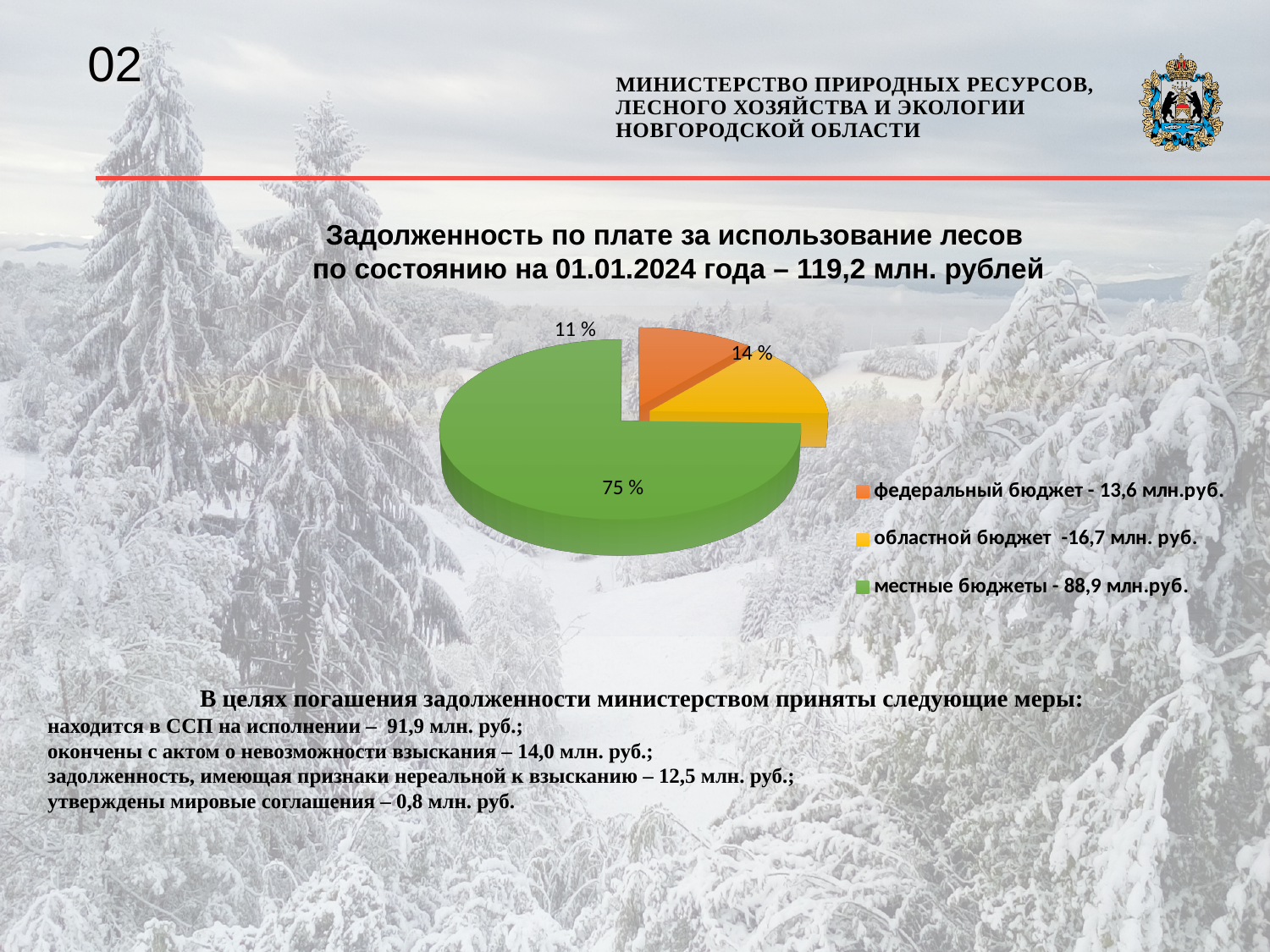
How many slices does the pie chart have? 3 According to the legend, what is the debt amount for местные бюджеты? 88,9 млн.руб. What share of the pie does the slice for областной бюджет represent? 14 % What is the difference in percentage points between the share for местные бюджеты and the share for федеральный бюджет? 64 How many entries does the legend of the pie chart list? 3 What share of the pie does the slice for местные бюджеты represent? 75 % According to the legend, what is the debt amount for федеральный бюджет? 13,6 млн.руб. Which category has the smallest slice of the pie? федеральный бюджет Which category has the largest slice of the pie? местные бюджеты What share of the pie does the slice for федеральный бюджет represent? 11 % What kind of chart is shown on the slide? pie chart Which is larger, the debt for областной бюджет or the debt for федеральный бюджет? областной бюджет